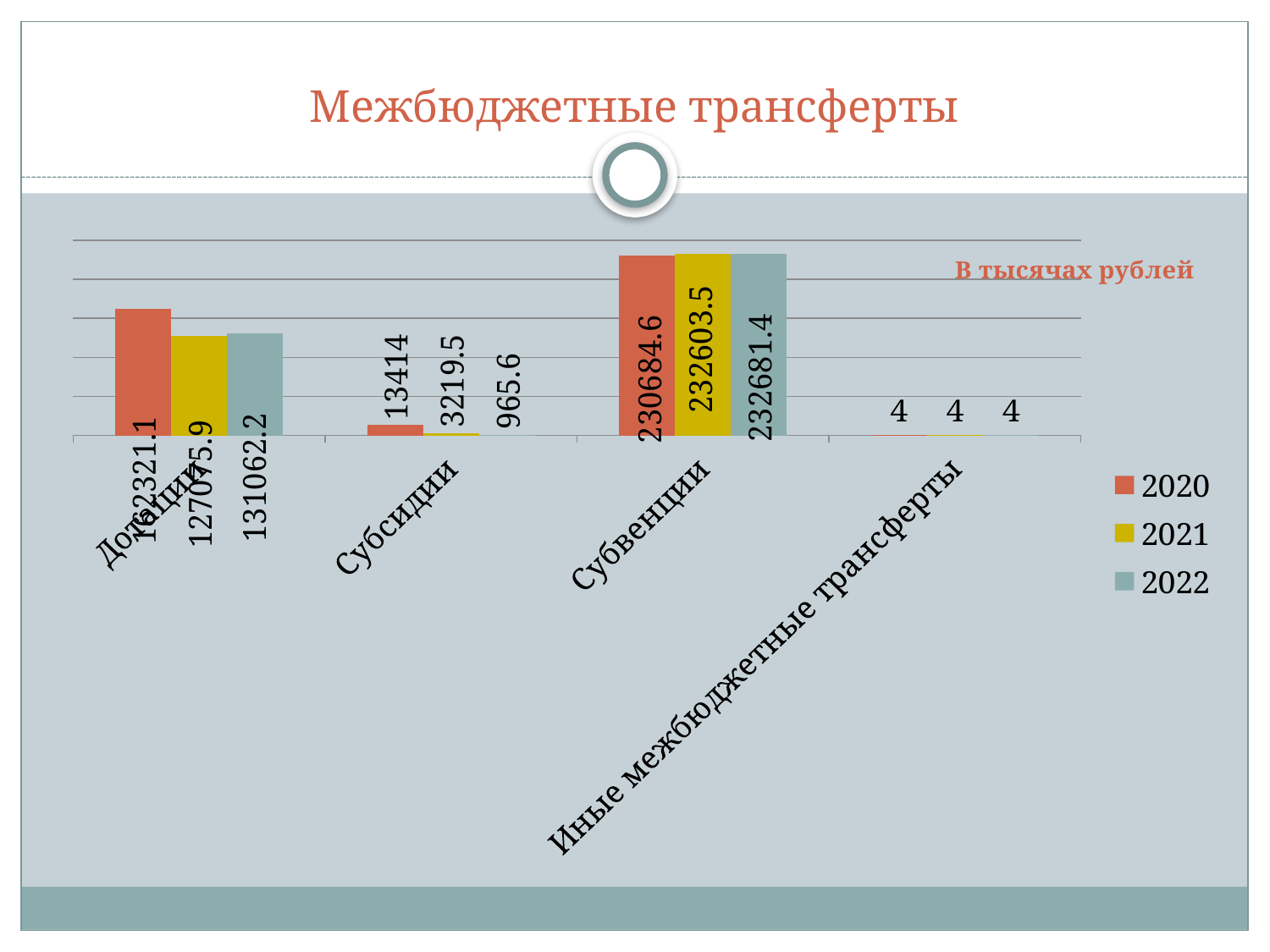
What is the value for Иные межбюджетные трансферты in 2022? 4 What kind of chart is shown on the slide? bar chart How many categories are shown on the x axis? 4 What is the difference between the 2020 and 2021 values for Субсидии? 10194.5 For Субвенции, which is larger: the 2020 value or the 2022 value? 2022 Which category has the lowest value for 2020? Иные межбюджетные трансферты What is the value for Дотации in 2022? 131062.2 What is the value for Субвенции in 2021? 232603.5 How many series does the legend list? 3 What is the value for Субсидии in 2020? 13414 Which category has the highest value for 2022? Субвенции Do the values for Субсидии rise or fall from 2020 to 2022? fall